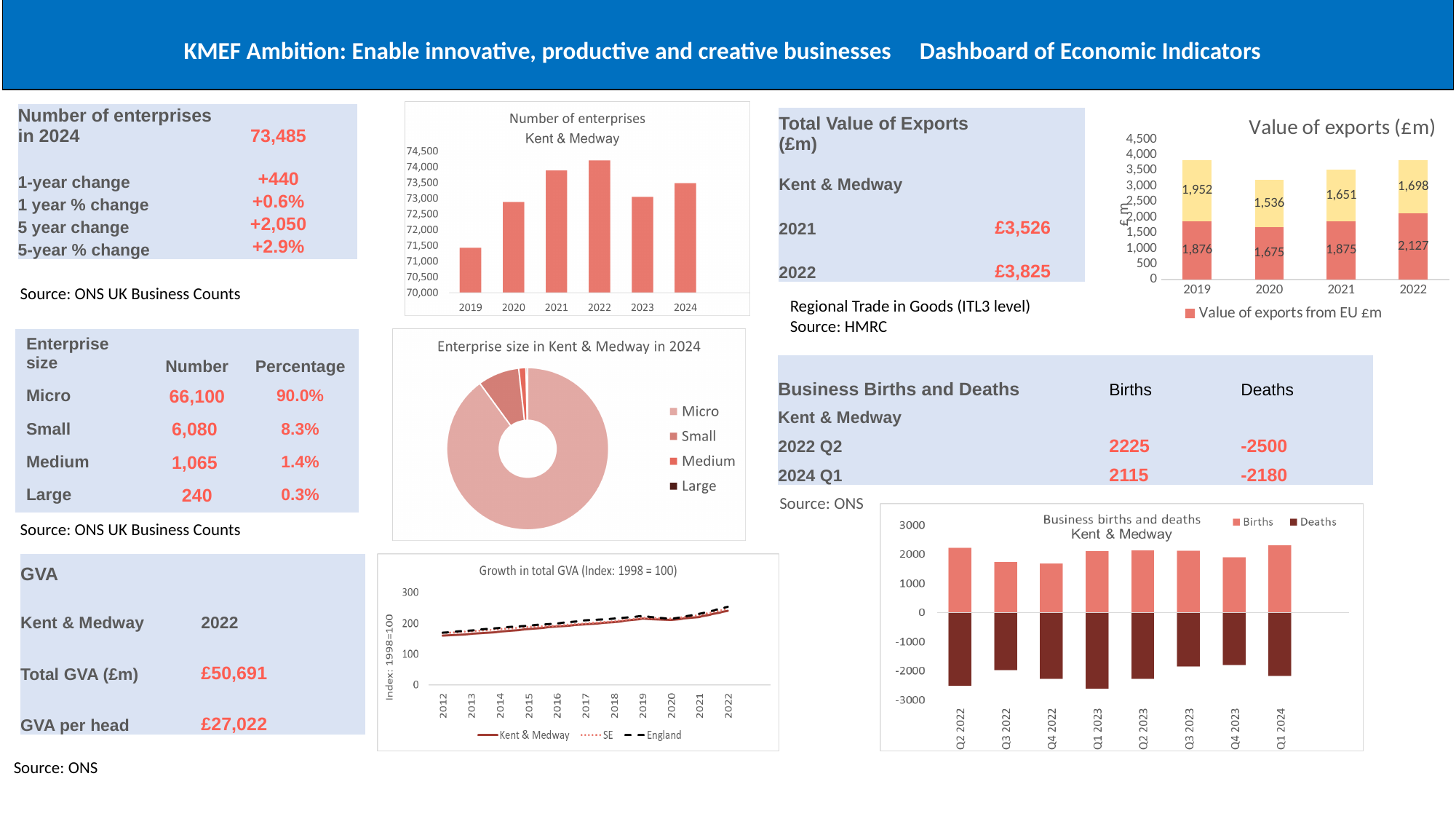
In the 'Number of enterprises Kent & Medway' chart, which year has the highest number of enterprises? 2022 In the 'Value of exports (£m)' chart, what is the value of the lower (red) segment for 2022? 2,127 In the 'Number of enterprises Kent & Medway' chart, which year has the lowest number of enterprises? 2019 In the 'Number of enterprises Kent & Medway' chart, is the value for 2019 greater or less than 72,000? less In the 'Enterprise size in Kent & Medway in 2024' doughnut chart, which category has the largest slice? Micro How many series does the legend of the 'Growth in total GVA (Index: 1998 = 100)' chart list? 3 How many years are shown on the x axis of the 'Number of enterprises Kent & Medway' chart? 6 In the 'Value of exports (£m)' chart, what is the difference between the lower segment values for 2022 and 2021? 252 In the 'Business births and deaths Kent & Medway' chart, is the Births value for Q3 2022 greater or less than 2000? less What type of chart is the 'Number of enterprises Kent & Medway' chart? bar chart In the 'Value of exports (£m)' chart, what is the value of the upper (yellow) segment for 2019? 1,952 In the 'Value of exports (£m)' chart, what is the total of the stacked bar for 2020? 3,211